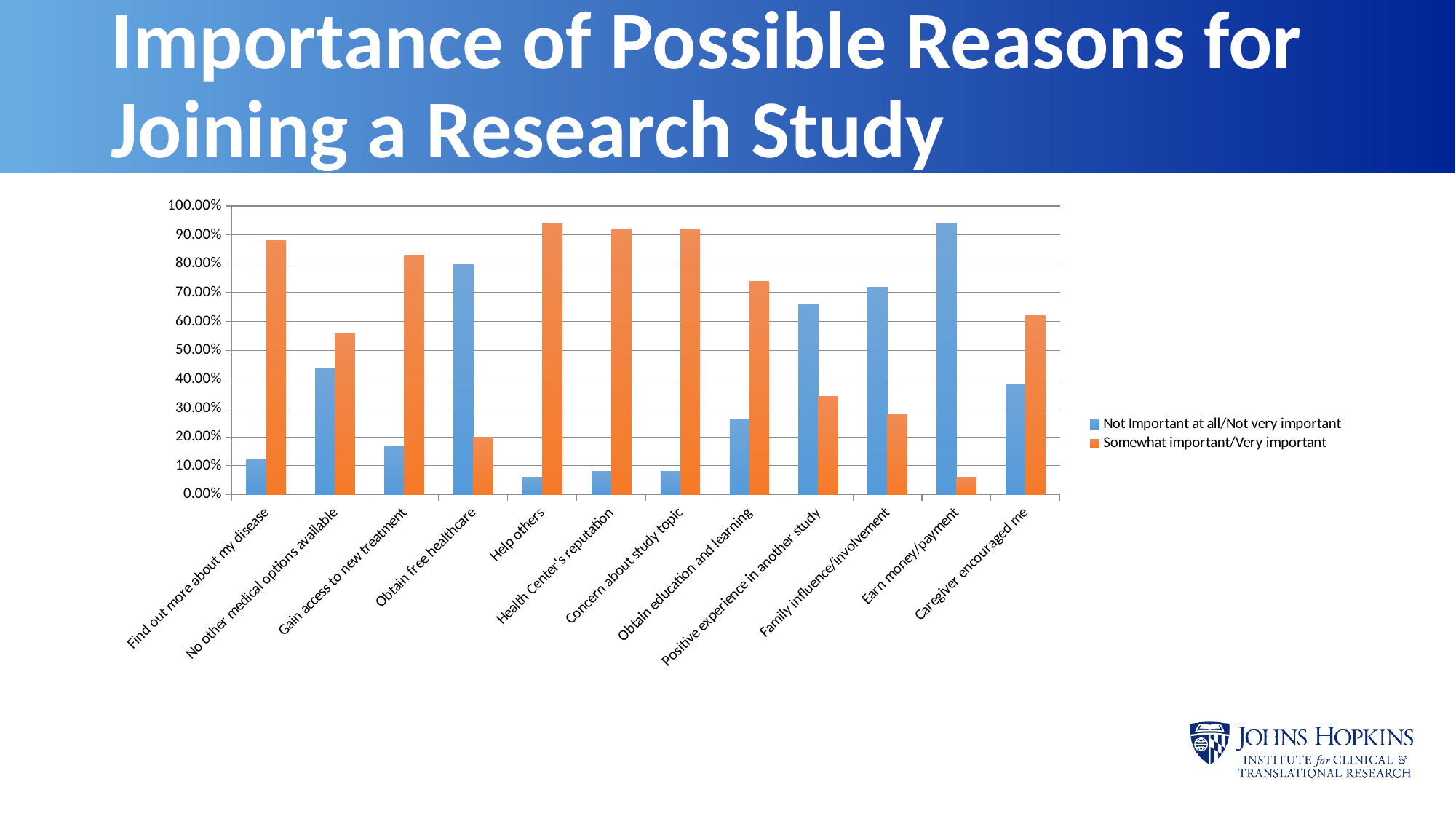
For 'Gain access to new treatment', which series has the larger value: 'Not Important at all/Not very important' or 'Somewhat important/Very important'? Somewhat important/Very important For 'Obtain free healthcare', which series has the larger value: 'Not Important at all/Not very important' or 'Somewhat important/Very important'? Not Important at all/Not very important How many reasons (categories) are shown on the x axis? 12 Is the 'Somewhat important/Very important' value for 'Help others' greater or less than 90.00%? greater What kind of chart is shown on the slide? bar chart Which reason has the highest value for the 'Not Important at all/Not very important' series? Earn money/payment Which reason has the lowest value for the 'Somewhat important/Very important' series? Earn money/payment Is the 'Not Important at all/Not very important' value for 'Find out more about my disease' greater or less than 20.00%? less Is the 'Somewhat important/Very important' value for 'Caregiver encouraged me' greater or less than 50.00%? greater How many series does the legend list? 2 What colour represents the 'Somewhat important/Very important' series? orange